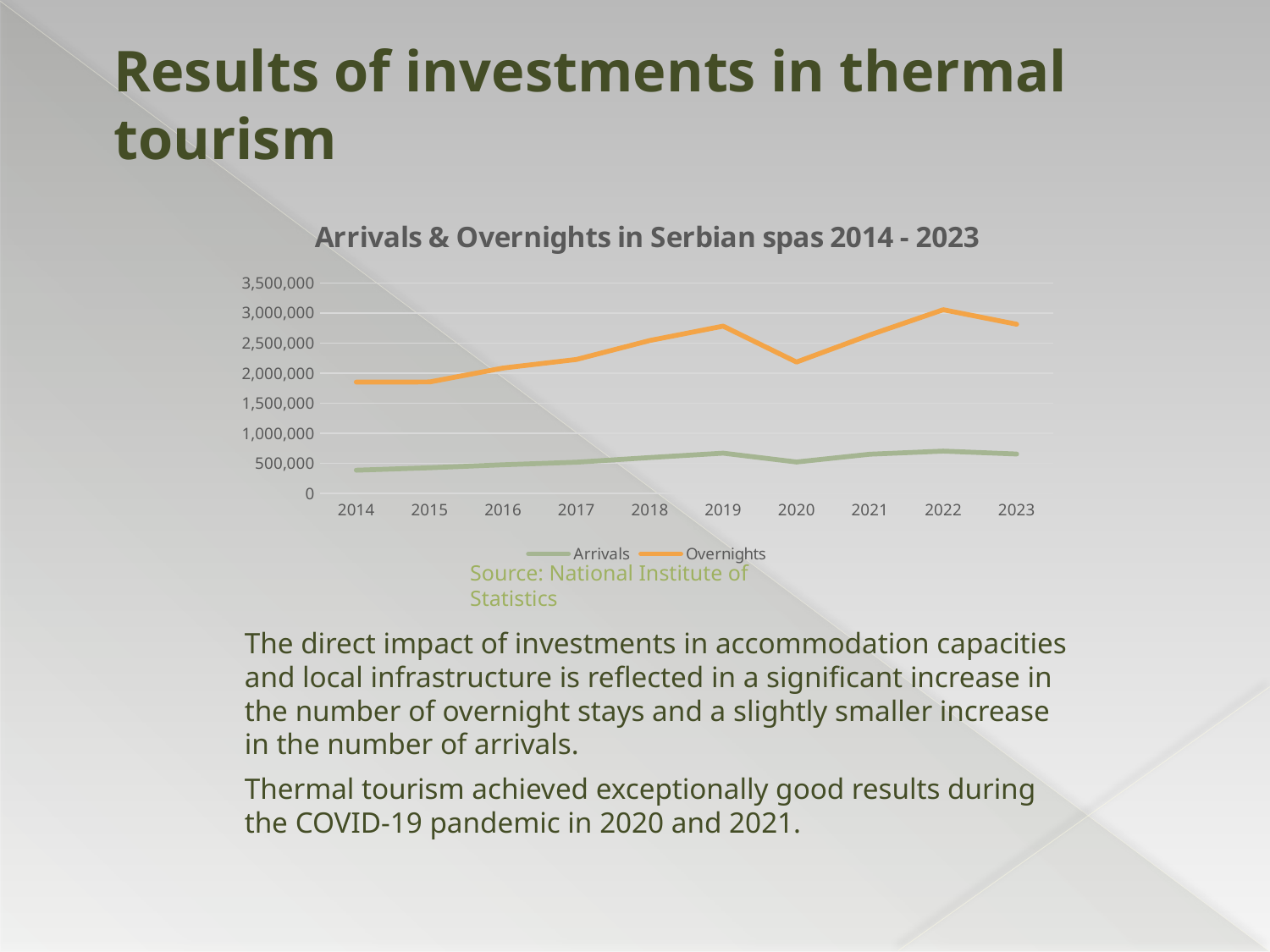
What is the title of the chart? Arrivals & Overnights in Serbian spas 2014 - 2023 How many series does the chart legend list? 2 What kind of chart is shown on the slide? line chart Which year has the larger Arrivals value, 2020 or 2022? 2022 In which year is the Overnights value highest? 2022 In which year is the Arrivals value lowest? 2014 Is the Overnights value for 2022 greater or less than 3,000,000? greater Is the Overnights value for 2014 greater or less than 2,000,000? less Do the Overnights values rise or fall from 2014 to 2019? rise How many years are plotted along the x axis of the chart? 10 Which year has the larger Overnights value, 2019 or 2020? 2019 Is the Arrivals value for 2014 greater or less than 500,000? less